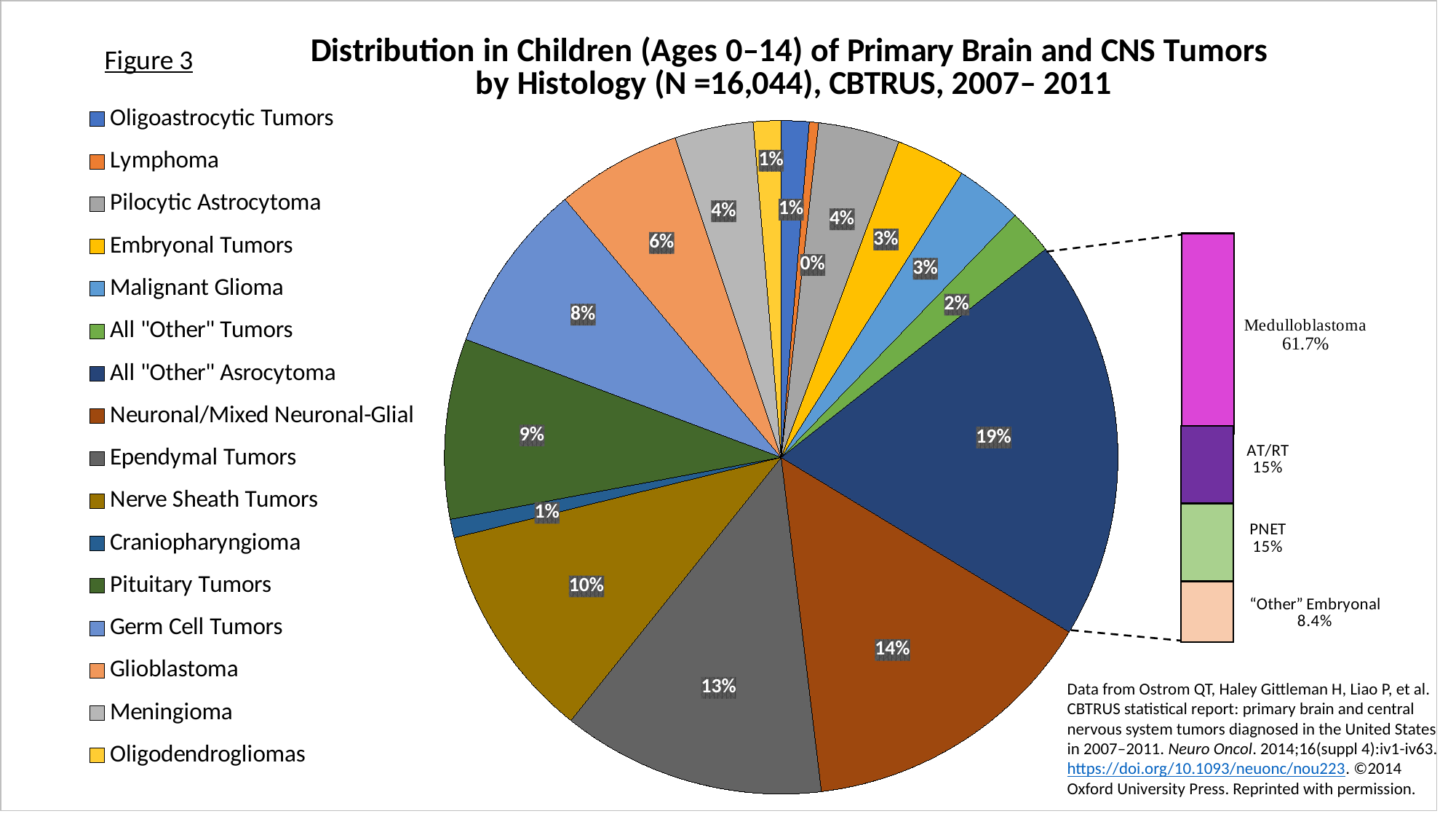
What percentage of the pie is Pituitary Tumors? 9% What is the N value stated in the chart title? 16,044 Which histology category has the largest slice of the pie? All "Other" Astrocytoma In the breakout bar of Embryonal Tumors, what percentage is "Other" Embryonal? 8.4% What kind of chart is shown on the slide? pie chart In the breakout bar of Embryonal Tumors, what percentage is Medulloblastoma? 61.7% Which category has the smallest labeled slice, at 0%? Lymphoma What percentage of the pie is All "Other" Astrocytoma? 19% What is the difference in percentage points between Neuronal/Mixed Neuronal-Glial (14%) and Nerve Sheath Tumors (10%)? 4 percentage points How many histology categories does the legend list? 16 What percentage of the pie is Ependymal Tumors? 13% Which slice is larger, Germ Cell Tumors or Glioblastoma? Germ Cell Tumors